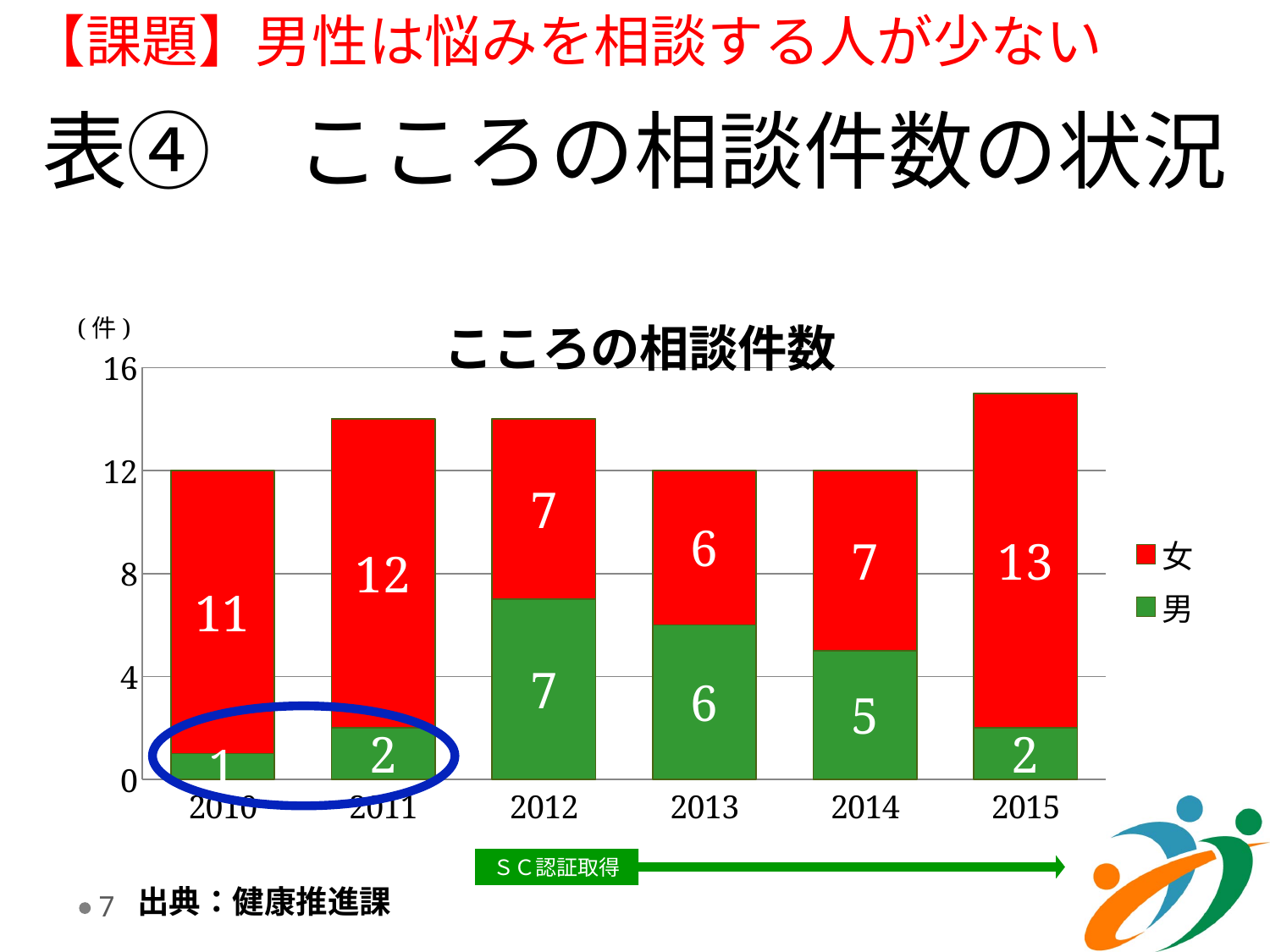
What is the value for 男 in 2010? 1 Which is larger in 2014, the value for 女 or the value for 男? 女 In which year is the value for 女 the highest? 2015 How many series does the legend list? 2 What is the total of the stacked bar for 2011? 14 What is the value for 男 in 2012? 7 In which year is the value for 男 the lowest? 2010 What is the total of the stacked bar for 2015? 15 What kind of chart is shown? Stacked bar chart What is the difference between the 女 and 男 values in 2011? 10 How many years are shown on the x axis? 6 What is the value for 女 in 2015? 13